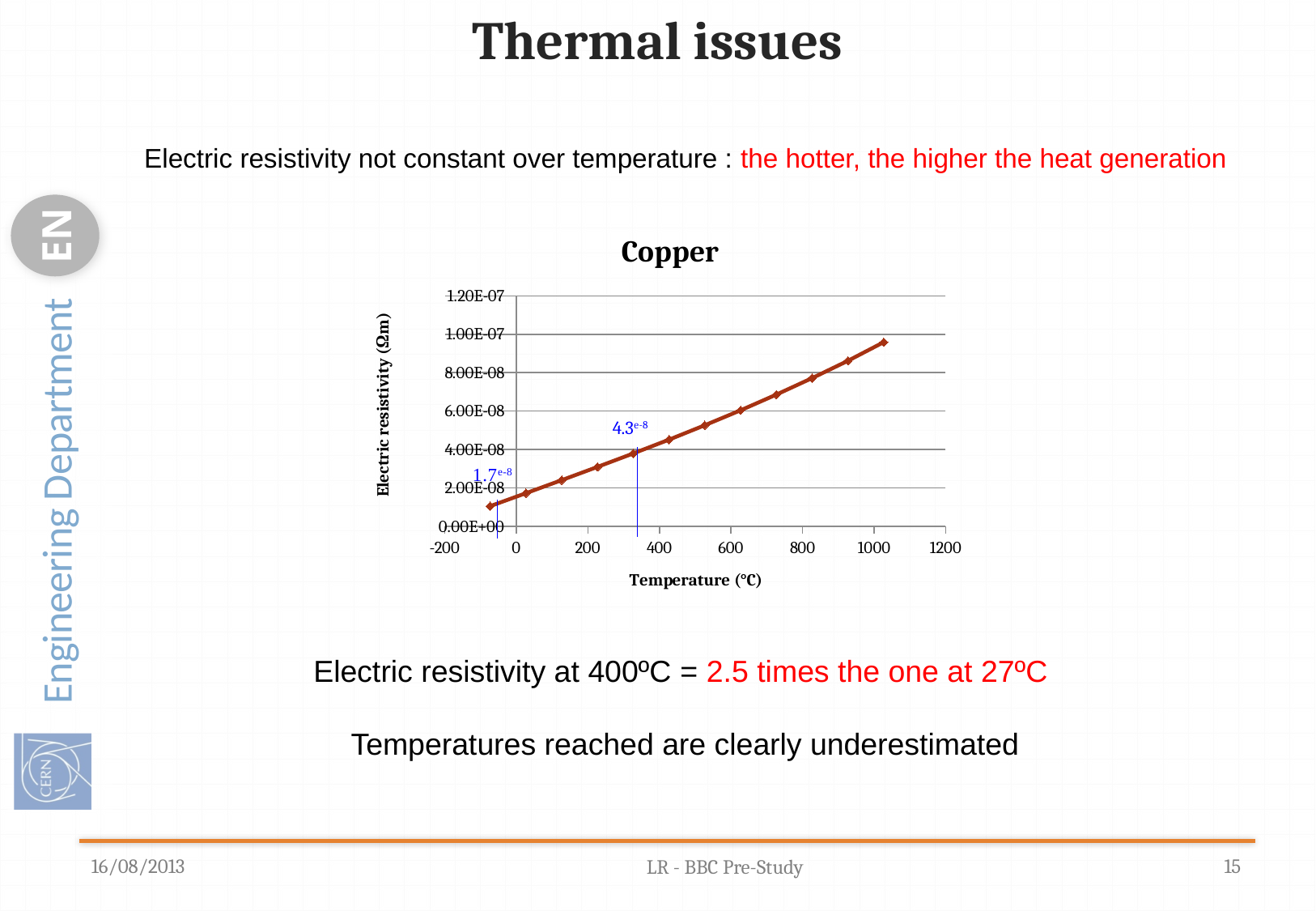
Is the electric resistivity at a temperature of about 800 °C greater or less than 6.00E-08 Ωm? greater Is the electric resistivity at a temperature of about 1000 °C greater or less than 8.00E-08 Ωm? greater What kind of chart is shown on the slide? line chart What is the label of the y axis of the chart? Electric resistivity (Ωm) How many data points are plotted on the line? 12 At which end of the temperature range is the electric resistivity highest, the lowest temperature or the highest temperature? the highest temperature Which is larger, the electric resistivity at about 200 °C or at about 800 °C? at about 800 °C Is the electric resistivity at a temperature of about 600 °C greater or less than 8.00E-08 Ωm? less What is the title of the chart? Copper Does electric resistivity rise or fall as temperature increases along the x axis? rise What is the highest value shown on the y axis of the chart? 1.20E-07